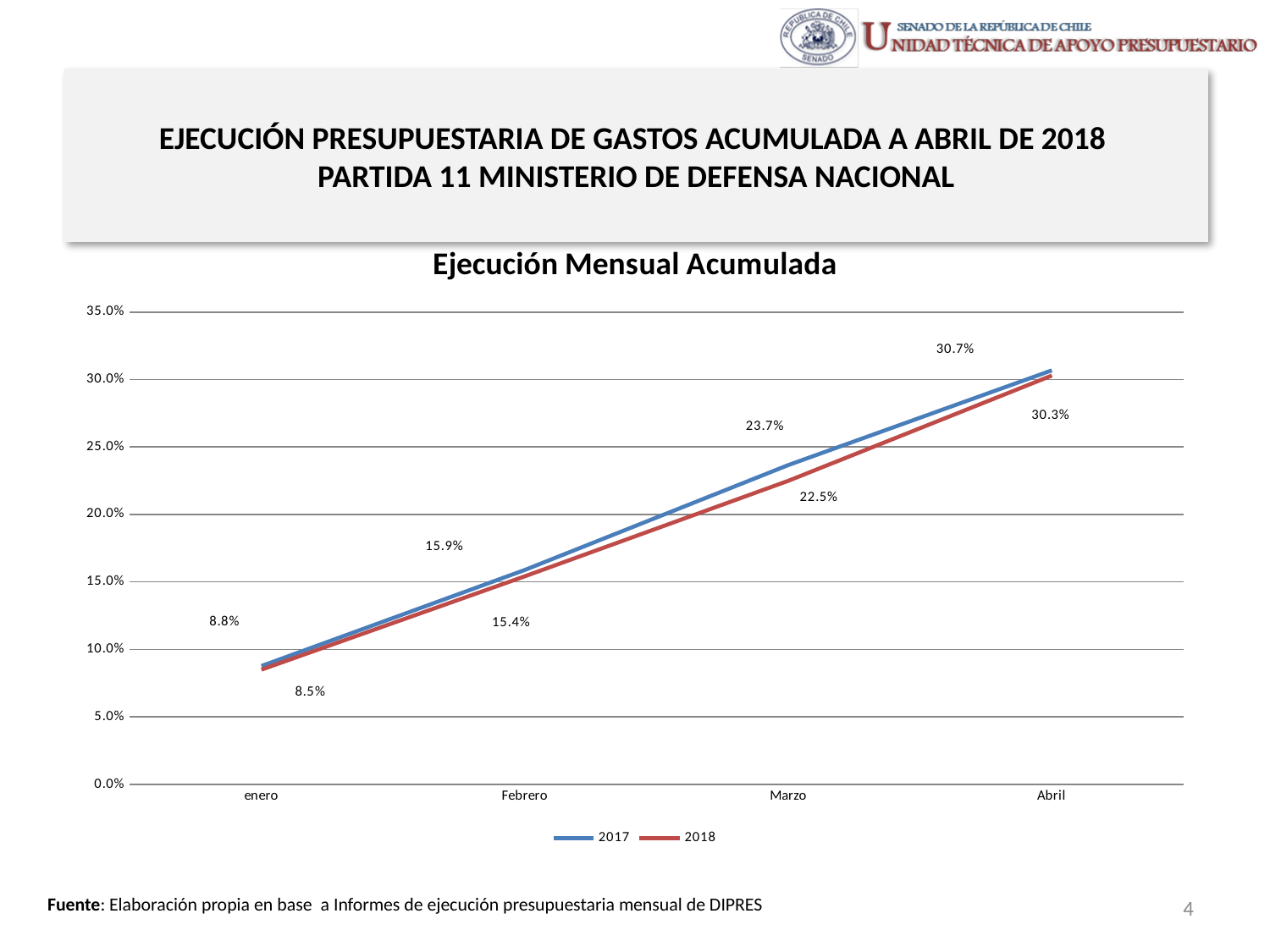
How many months are plotted on the x axis? 4 In which month is the 2017 series at its highest? Abril What is the difference between the 2017 and 2018 values in Marzo? 1.2% What is the value for 2018 in Marzo? 22.5% Do the values for 2018 rise or fall from enero to Abril? rise How many series does the legend list? 2 What is the value for 2018 in Febrero? 15.4% In which month is the 2018 series at its lowest? enero What type of chart is shown under the title "Ejecución Mensual Acumulada"? line chart Which series has the higher value in Abril, 2017 or 2018? 2017 What is the value for 2017 in enero? 8.8% What is the value for 2017 in Abril? 30.7%